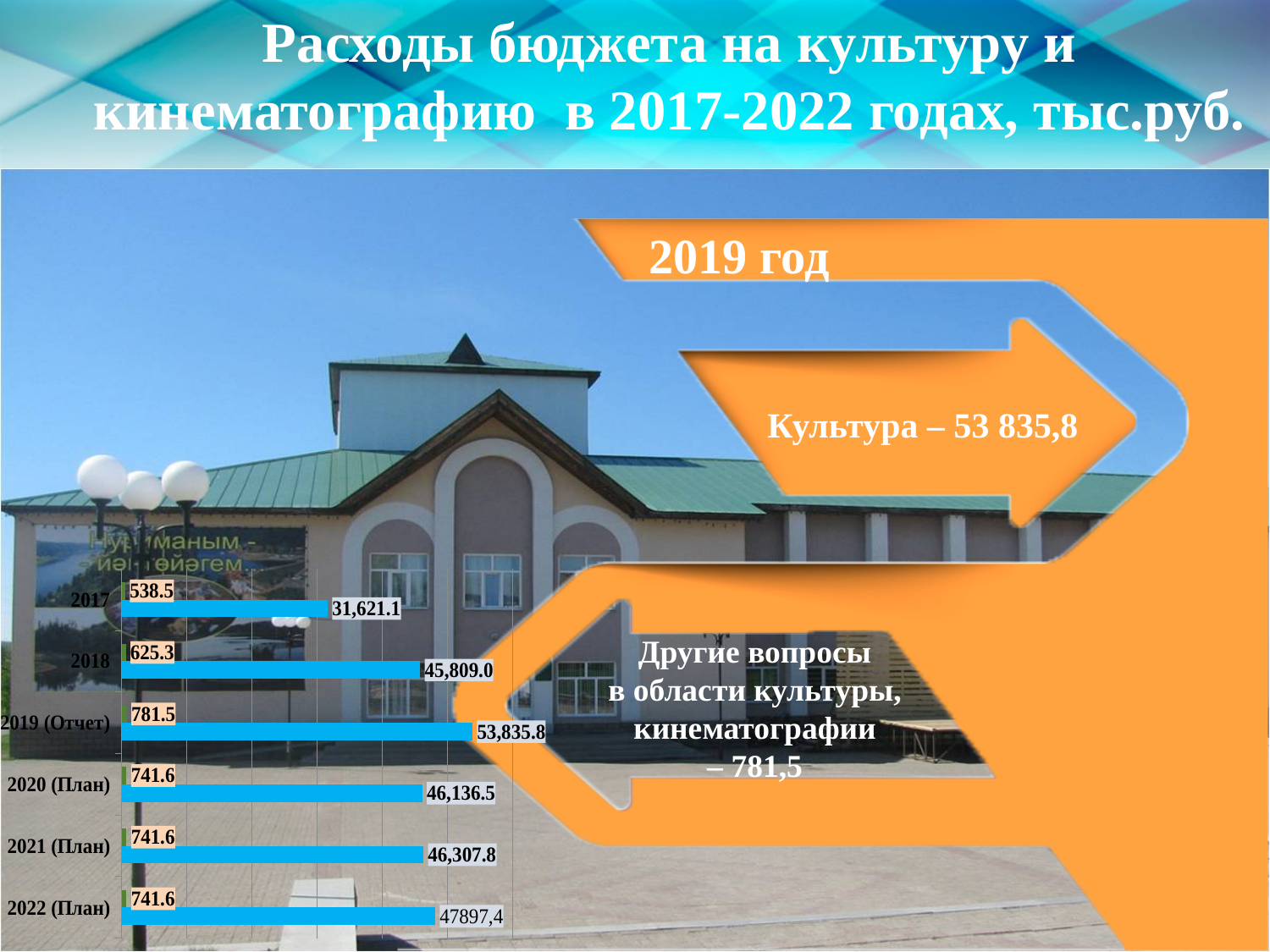
Which category has the highest value for the blue bars? 2019 (Отчет) What is the value of the blue bar for 2019 (Отчет)? 53,835.8 What is the value of the small green bar for 2018? 625.3 How many categories (years) are shown on the chart? 6 Do the blue bar values rise or fall from 2017 to 2019 (Отчет)? Rise What is the value of the blue bar for 2017? 31,621.1 What type of chart is shown on the slide? Bar chart Which is larger, the blue bar for 2020 (План) or the blue bar for 2021 (План)? 2021 (План) Which category has the lowest value for the blue bars? 2017 What is the difference between the blue bar values for 2019 (Отчет) and 2018? 8,026.8 What is the value of the blue bar for 2022 (План)? 47897,4 Which category has the lowest value for the small green bars? 2017